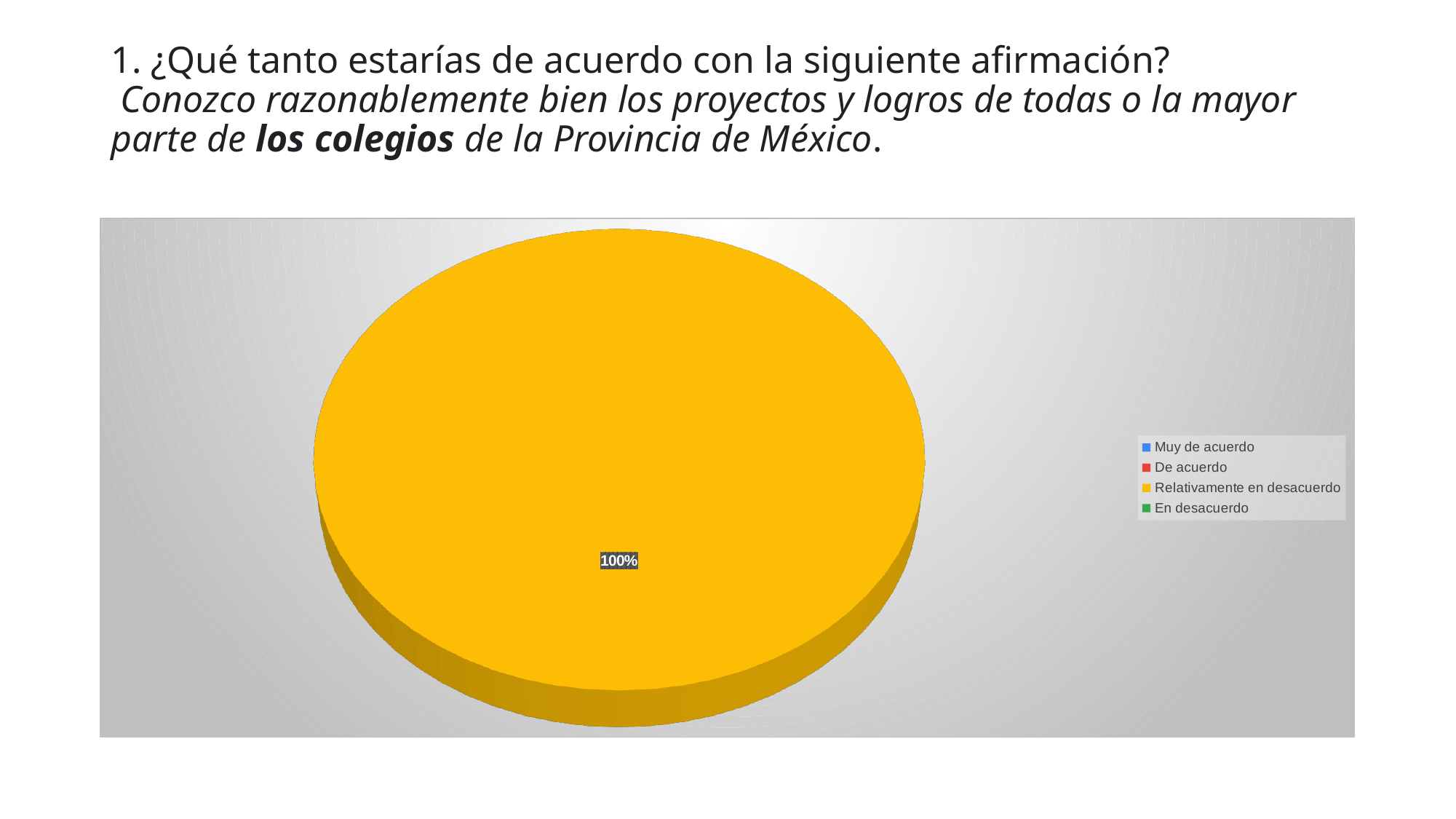
What kind of chart is shown on the slide? pie chart How many slices are visible in the pie? 1 Is the share for Relativamente en desacuerdo greater or less than 50%? greater How many entries does the legend list? 4 Which legend category does the single visible slice of the pie correspond to? Relativamente en desacuerdo What is the first entry listed in the legend? Muy de acuerdo What is the value shown on the data label of the pie slice? 100% Which category has the largest share of the pie? Relativamente en desacuerdo What colour is the slice for Relativamente en desacuerdo? yellow What share of the pie does the slice labelled 100% represent? 100%